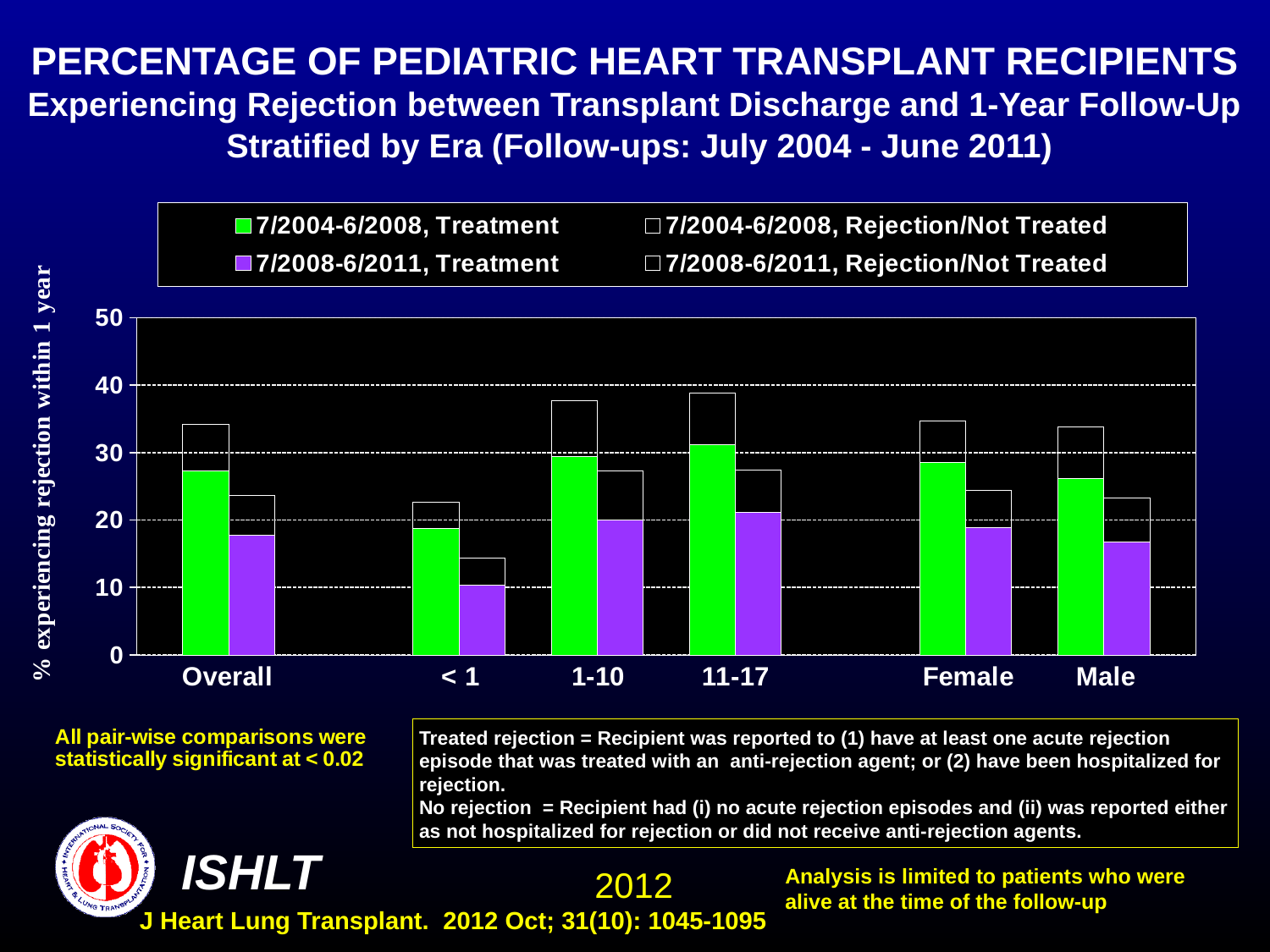
Is the 7/2008-6/2011, Treatment value for Male greater or less than 20? less Is the 7/2004-6/2008, Treatment value for Female greater or less than 20? greater Which category has the lowest total stacked bar for the 7/2004-6/2008 era? < 1 Which category has the lowest value for 7/2008-6/2011, Treatment? < 1 Is the total stacked bar for the 7/2004-6/2008 era in the 1-10 category greater or less than 30? greater How many categories are shown along the x axis? 6 For the Overall category, which is larger: the 7/2004-6/2008, Treatment value or the 7/2008-6/2011, Treatment value? 7/2004-6/2008, Treatment What kind of chart is shown on the slide? bar chart How many series does the legend list? 4 What is the label of the y axis? % experiencing rejection within 1 year